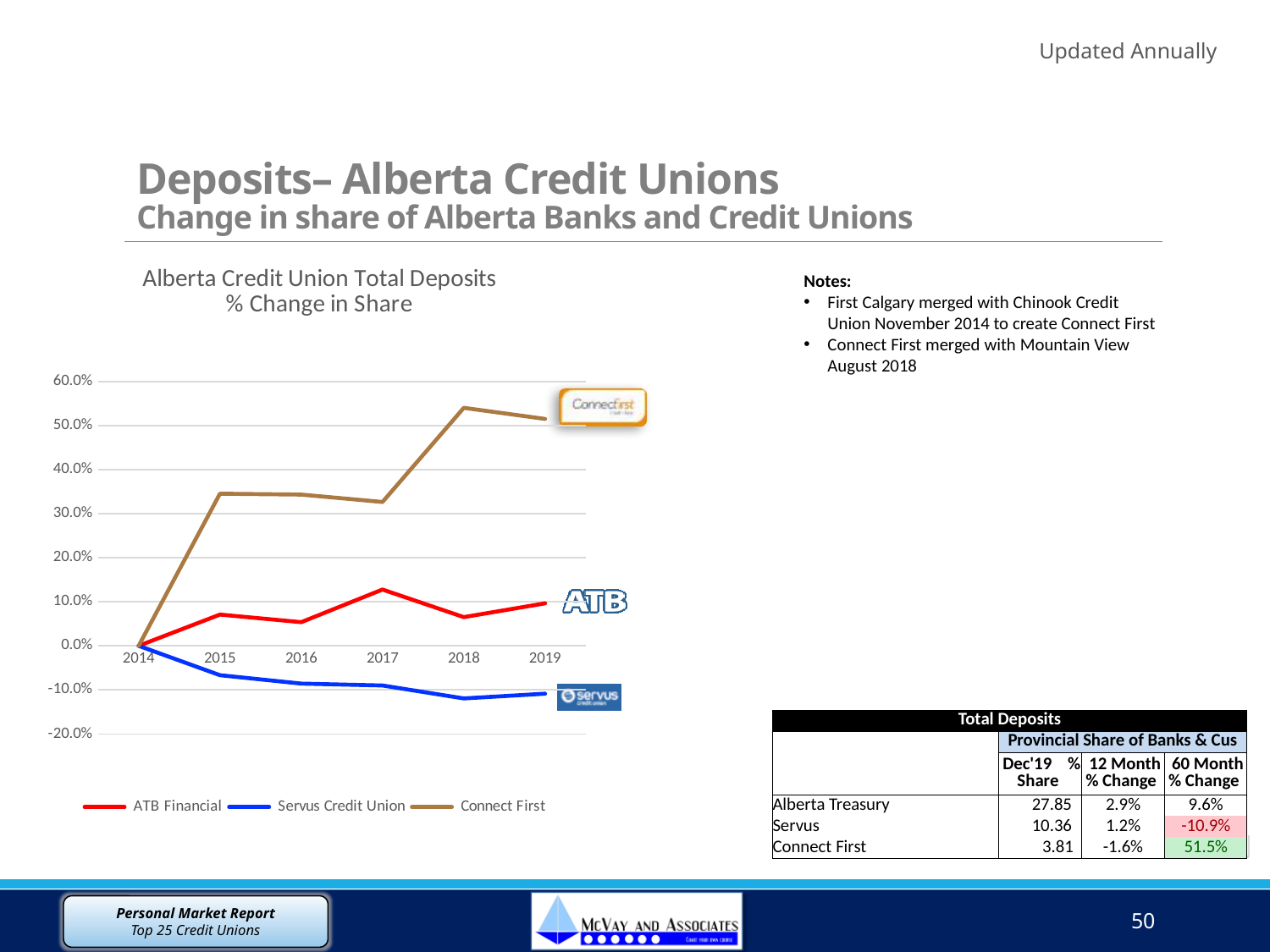
Is the value for Connect First in 2015 greater or less than 30.0%? greater Does the Servus Credit Union line rise or fall from 2014 to 2019? Fall Is the value for Servus Credit Union in 2018 greater or less than -10.0%? less Which series has the lowest value in 2019? Servus Credit Union How many series does the chart legend list? 3 What is the title of the chart? Alberta Credit Union Total Deposits % Change in Share Which is larger in 2017, the value for ATB Financial or the value for Connect First? Connect First What kind of chart is shown on the slide? Line chart Which series has the highest value in 2019? Connect First Is the value for ATB Financial in 2017 greater or less than 10.0%? greater How many years are plotted along the x axis of the chart? 6